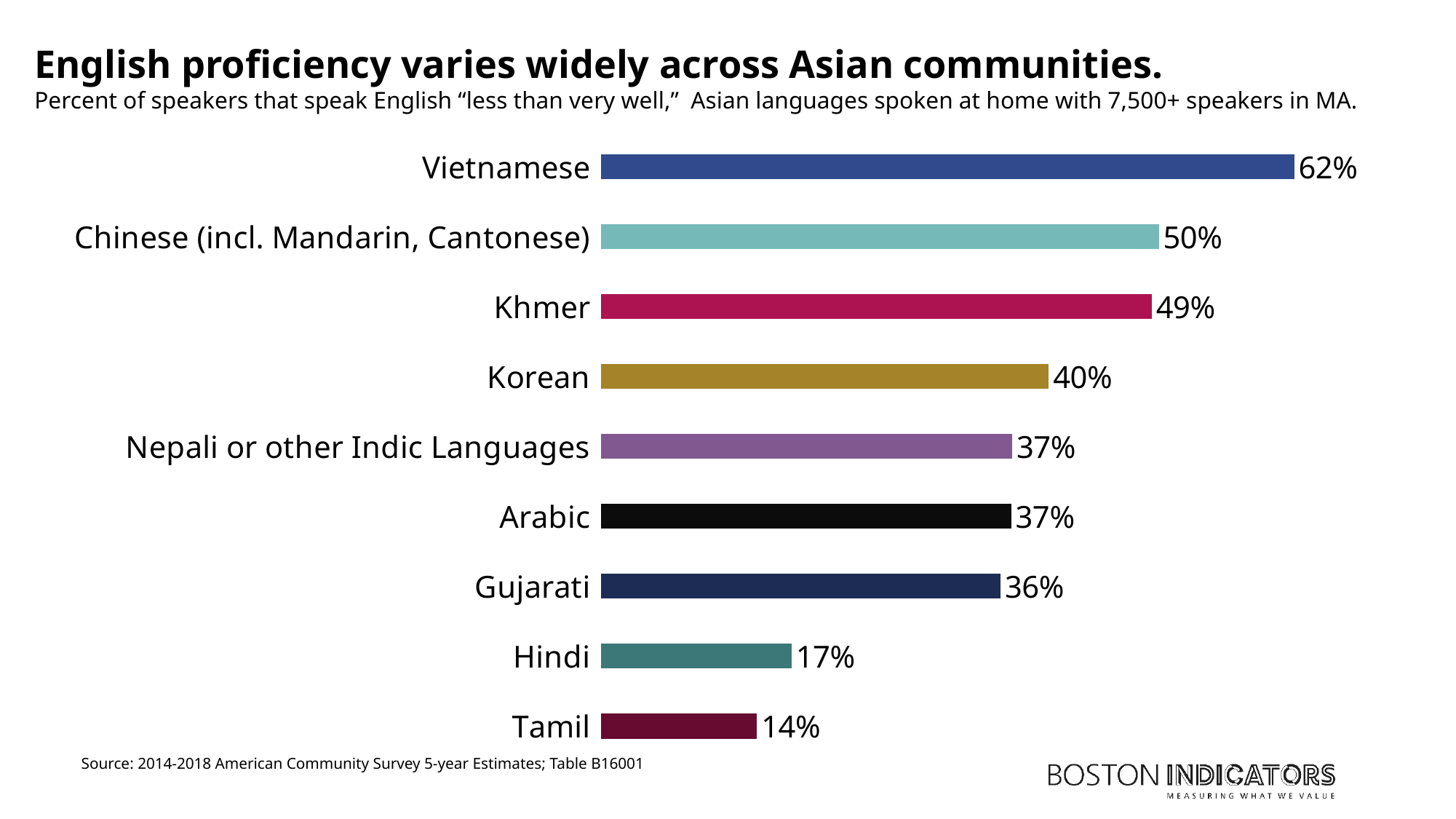
Which language has the lowest value on the chart? Tamil How many languages are shown on the chart? 9 What is the difference between the values for Chinese (incl. Mandarin, Cantonese) and Korean? 10% What is the value shown for Hindi? 17% Which has a larger value, Hindi or Tamil? Hindi What kind of chart is shown on the slide? Bar chart What percent of Vietnamese speakers speak English "less than very well"? 62% Which language has the highest percent of speakers who speak English "less than very well"? Vietnamese What is the difference between the values for Vietnamese and Tamil? 48% What is the value shown for Korean? 40% What is the source cited for the chart data? 2014-2018 American Community Survey 5-year Estimates; Table B16001 Which has a larger value, Khmer or Gujarati? Khmer